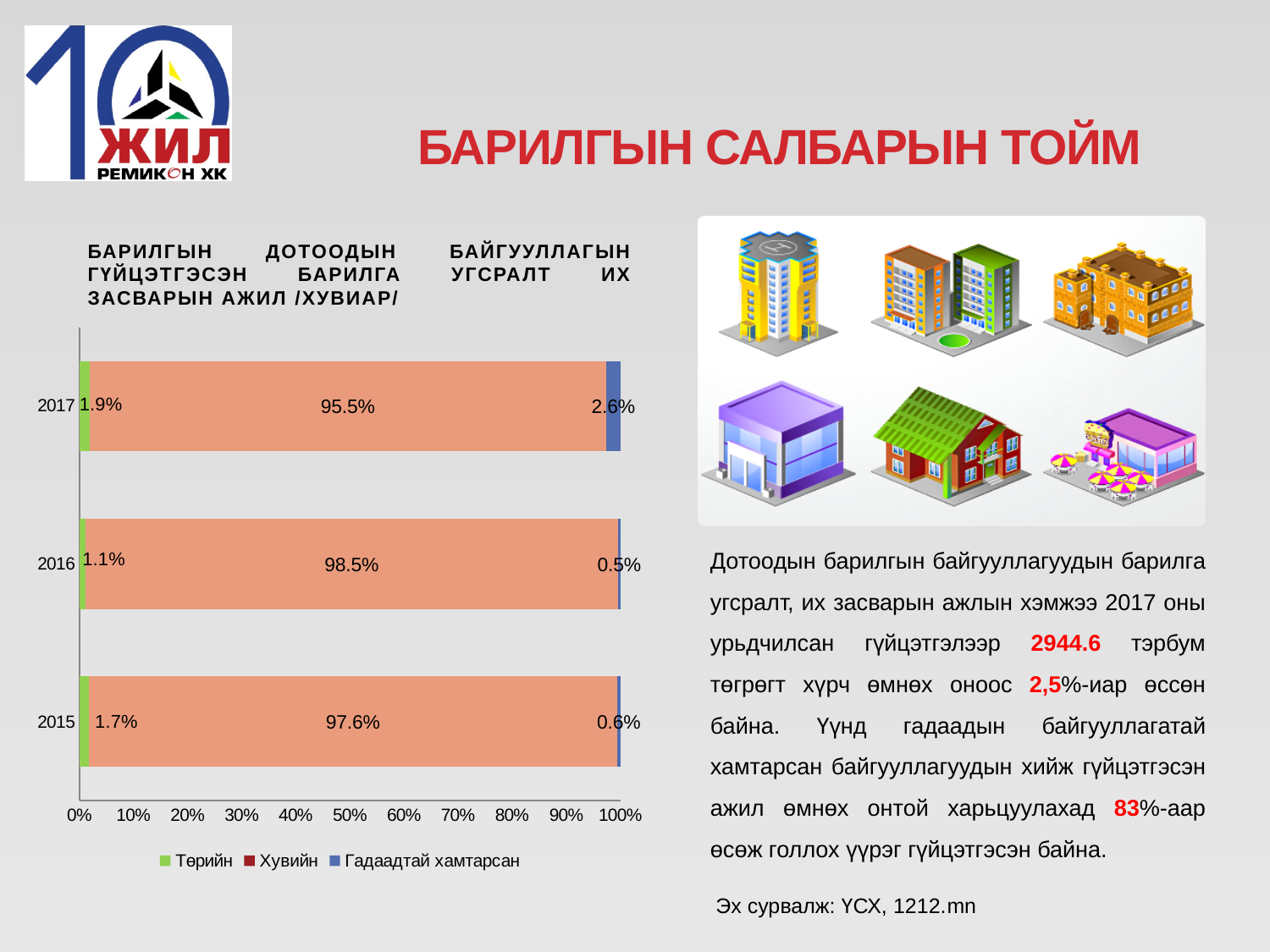
Which is larger, the Төрийн value for 2015 or for 2017? 2017 In which year is the Гадаадтай хамтарсан share lowest? 2016 In which year is the Хувийн share highest? 2016 What is the value for Төрийн in 2016? 1.1% What kind of chart is shown on the slide? Stacked bar chart What is the value for Хувийн in 2017? 95.5% What is the value for Гадаадтай хамтарсан in 2017? 2.6% How many series does the legend list? 3 What is the value for Гадаадтай хамтарсан in 2015? 0.6% What is the difference between the Хувийн values for 2016 and 2017? 3.0% Which legend entry is shown in green? Төрийн How many years are shown on the chart? 3